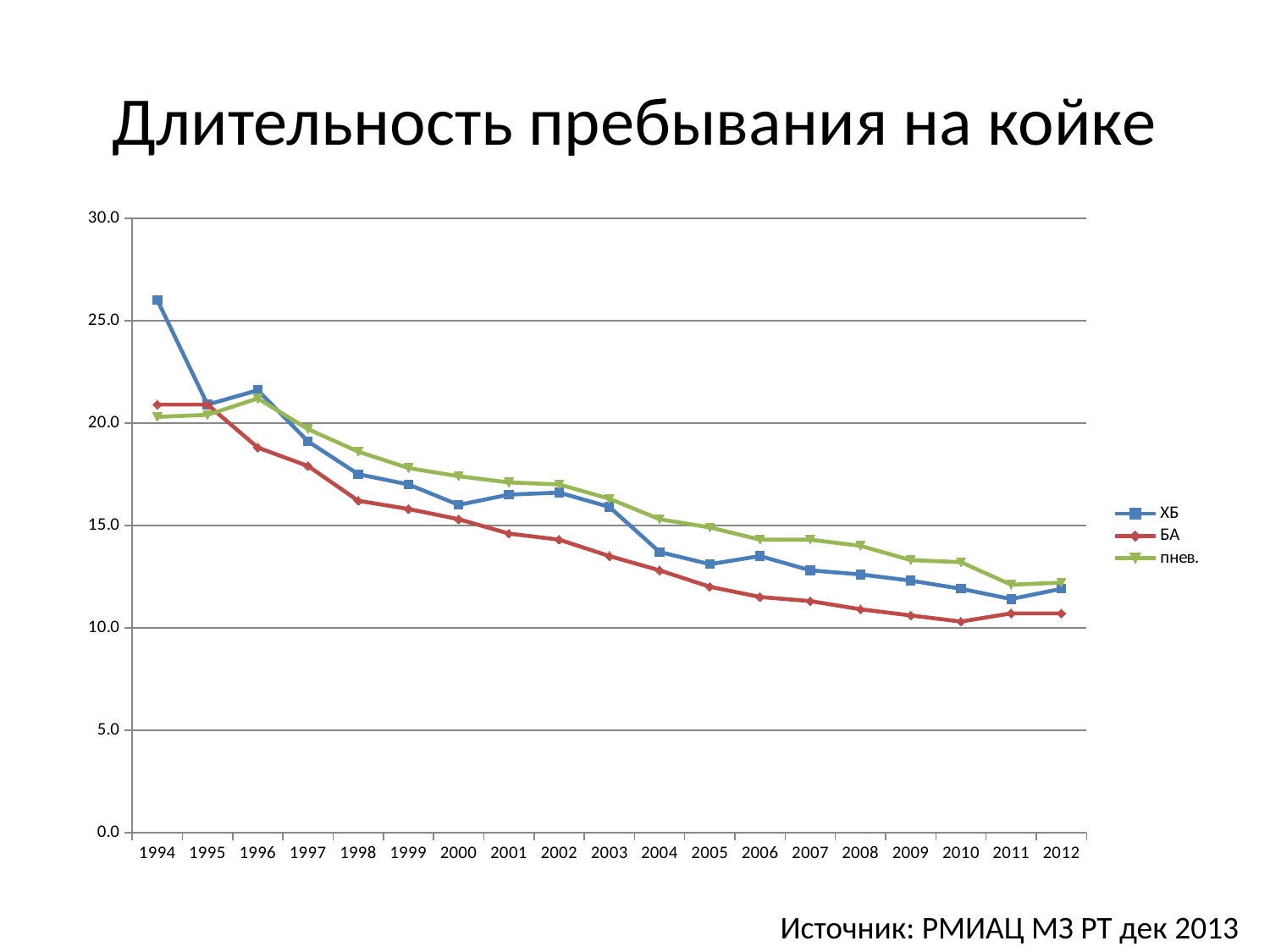
What is the title of the chart? Длительность пребывания на койке Is the value for БА in 2010 greater or less than 15.0? less Is the value for ХБ in 2004 greater or less than 15.0? less In 2012, which series has the higher value, БА or пнев.? пнев. What kind of chart is shown on the slide? line chart How many years are shown along the x axis? 19 How many series does the legend list? 3 Is the value for ХБ in 1994 greater or less than 25.0? greater Does the ХБ series rise or fall from 1994 to 2012? fall Which series has the lowest value in 2008? БА In 1994, which series has the higher value, ХБ or БА? ХБ